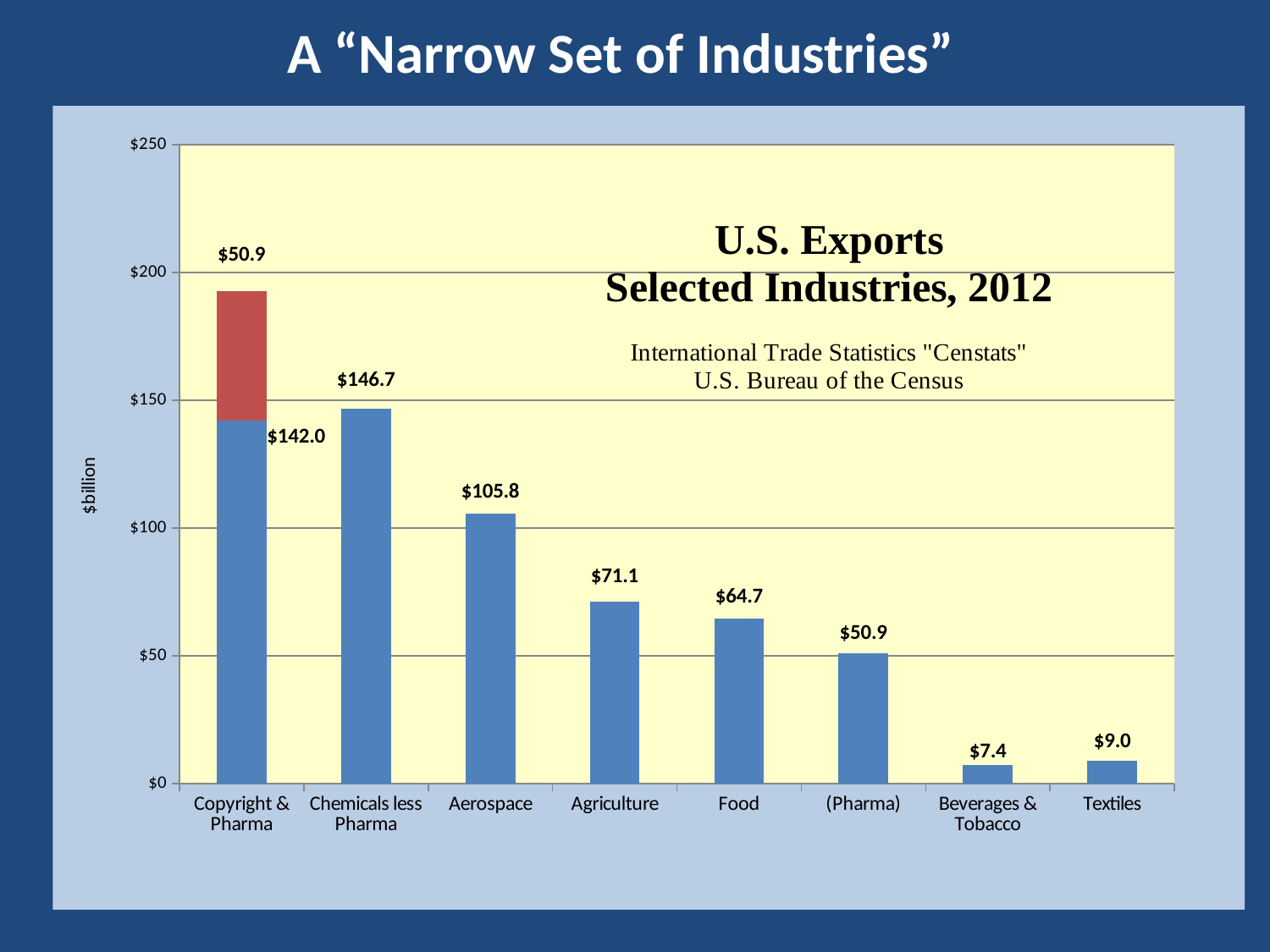
What is the total of the stacked Copyright & Pharma bar? $192.9 What is the value of the red segment on top of the Copyright & Pharma bar? $50.9 Which category has the lowest value? Beverages & Tobacco What is the label on the vertical axis? $billion Is the value for Food greater or less than $50? greater What kind of chart is this? bar chart What is the value of the blue segment of the Copyright & Pharma bar? $142.0 What is the value for Agriculture? $71.1 How many industry categories are shown on the x axis? 8 What is the value for Aerospace? $105.8 Which is larger, the value for Textiles or the value for Beverages & Tobacco? Textiles What is the difference between the values for Aerospace and Agriculture? $34.7